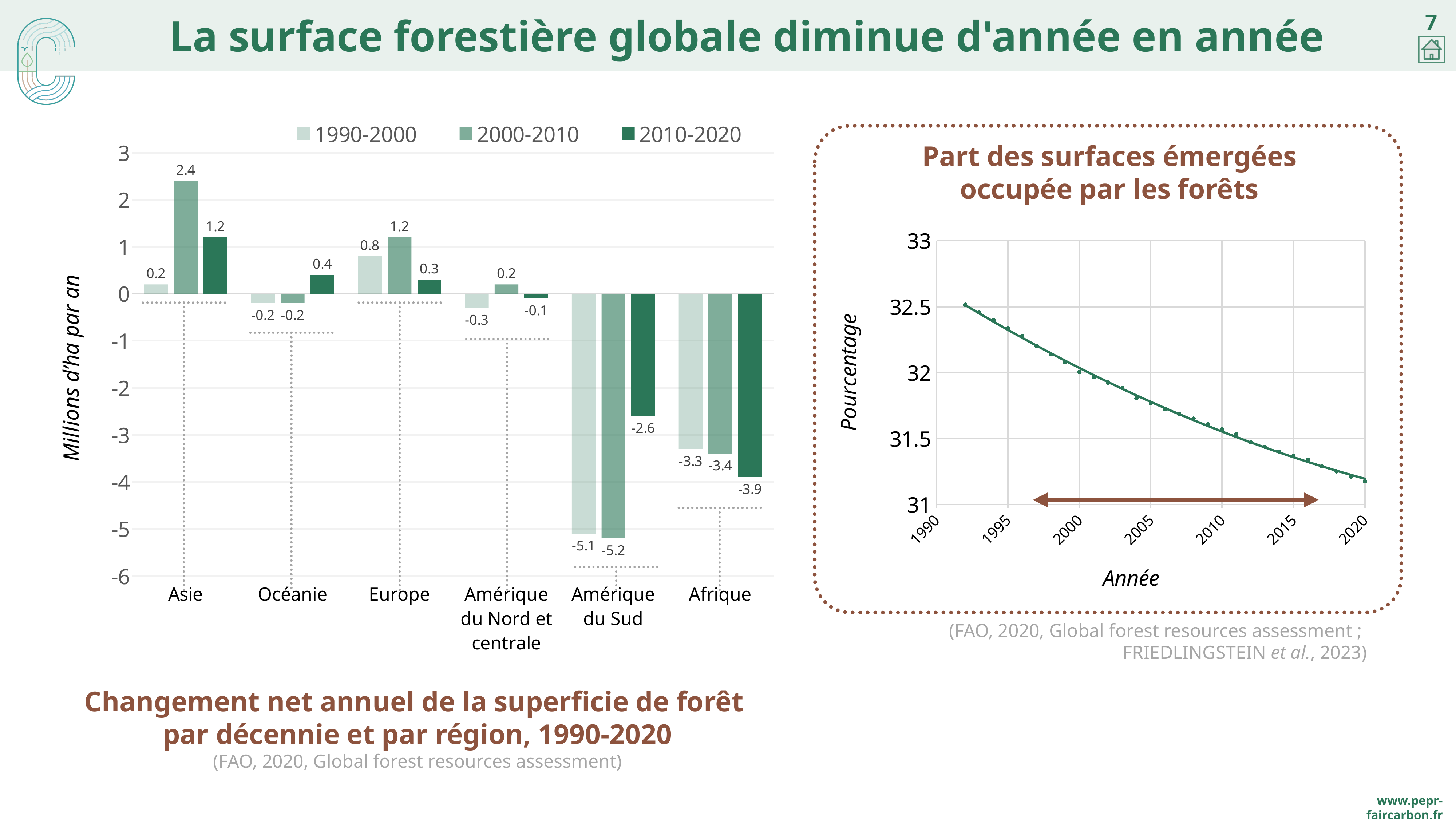
In the bar chart 'Changement net annuel de la superficie de forêt par décennie et par région, 1990-2020', what is the value for Afrique in 2010-2020? -3.9 In the bar chart 'Changement net annuel de la superficie de forêt par décennie et par région, 1990-2020', what is the value for Amérique du Sud in 1990-2000? -5.1 In the bar chart 'Changement net annuel de la superficie de forêt par décennie et par région, 1990-2020', what is the value for Asie in 2000-2010? 2.4 What kind of chart is 'Part des surfaces émergées occupée par les forêts'? Line chart How many regions are shown on the x axis of the bar chart 'Changement net annuel de la superficie de forêt par décennie et par région, 1990-2020'? 6 In the chart 'Part des surfaces émergées occupée par les forêts', is the value for 2020 greater or less than 31.5? less In the bar chart 'Changement net annuel de la superficie de forêt par décennie et par région, 1990-2020', which region has the highest value in the 2010-2020 series? Asie In the bar chart 'Changement net annuel de la superficie de forêt par décennie et par région, 1990-2020', which is larger for Europe: the 1990-2000 value or the 2000-2010 value? 2000-2010 In the bar chart 'Changement net annuel de la superficie de forêt par décennie et par région, 1990-2020', which region has the lowest value in the 2000-2010 series? Amérique du Sud In the bar chart 'Changement net annuel de la superficie de forêt par décennie et par région, 1990-2020', what is the difference between the Amérique du Sud values for 1990-2000 and 2010-2020? 2.5 How many series does the legend of the bar chart 'Changement net annuel de la superficie de forêt par décennie et par région, 1990-2020' list? 3 In the chart 'Part des surfaces émergées occupée par les forêts', do the values rise or fall from 1990 to 2020? Fall